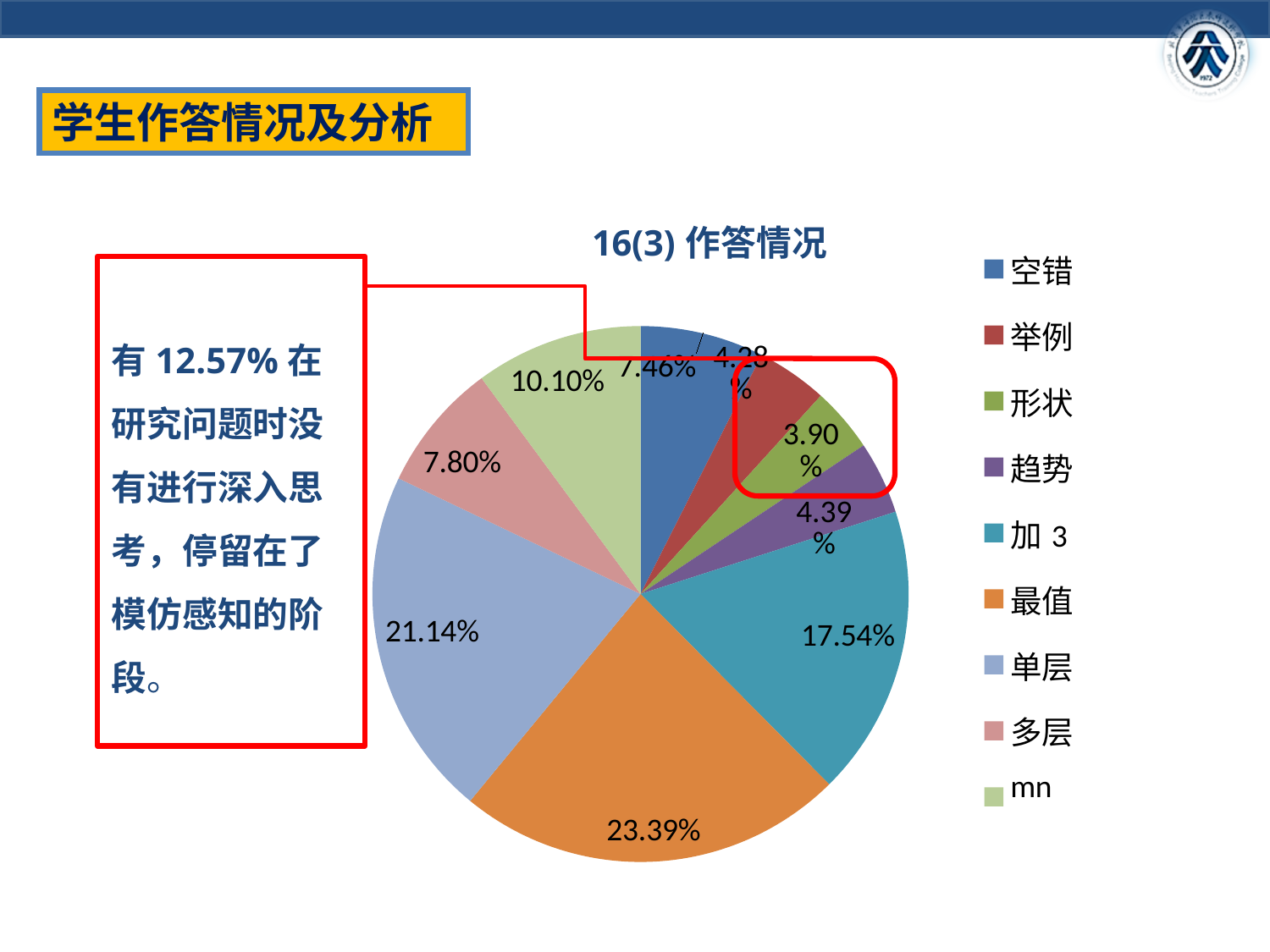
What kind of chart is shown on the slide? pie chart What percentage does the 加 3 slice show? 17.54% What percentage does the 单层 slice show? 21.14% What percentage does the 多层 slice show? 7.80% What percentage does the 最值 slice show? 23.39% How many categories does the legend list? 9 Which is larger, the share for 单层 or the share for 加 3? 单层 What percentage does the 形状 slice show? 3.90% Which category has the smallest share of the pie? 形状 Which category has the largest share of the pie? 最值 What is the title of the chart? 16(3) 作答情况 What percentage does the mn slice show? 10.10%